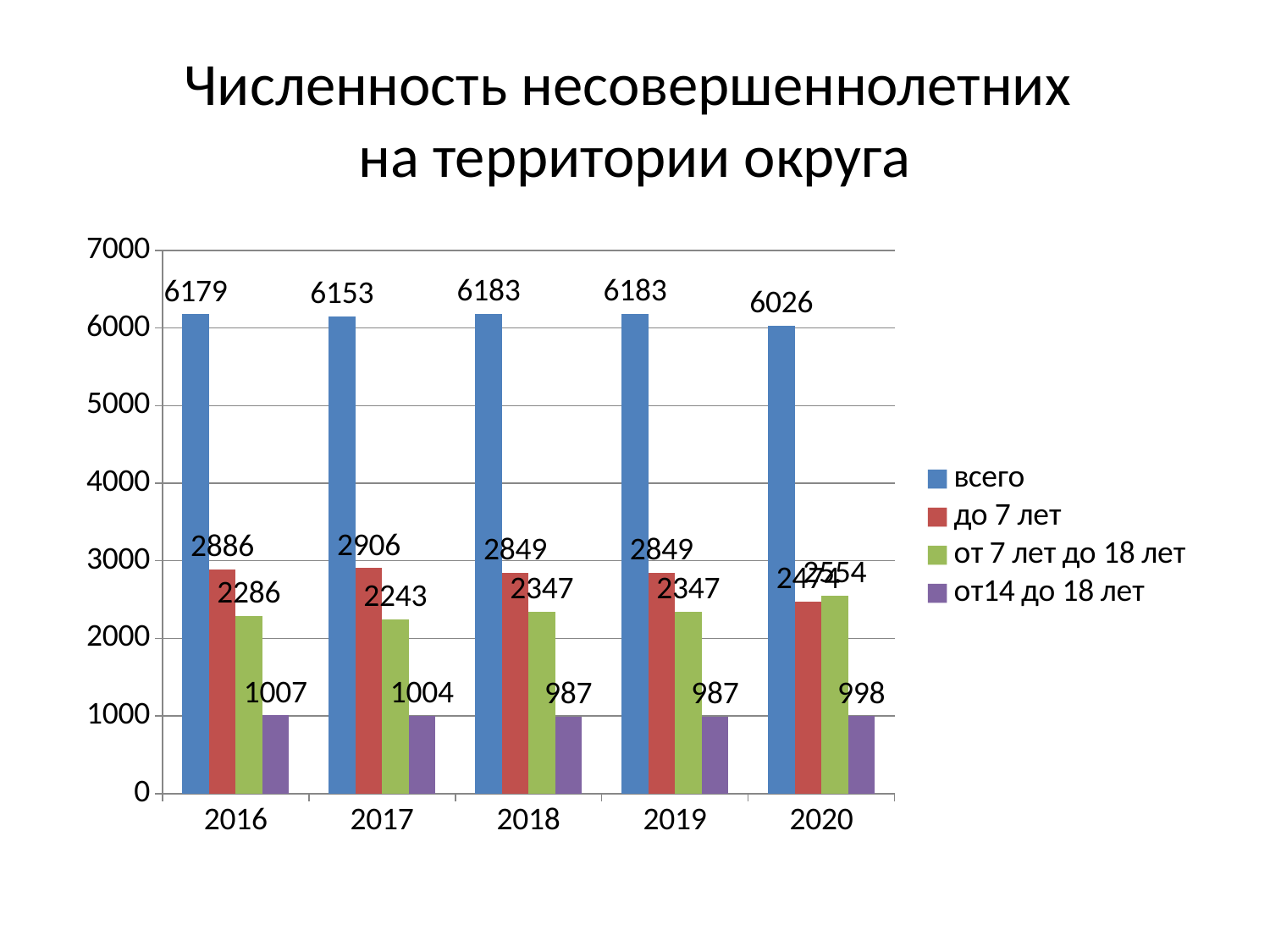
What kind of chart is shown on the slide? bar chart In which year is the "от14 до 18 лет" value highest? 2016 What is the value for "всего" in 2016? 6179 What is the value for "до 7 лет" in 2017? 2906 What is the difference between the "всего" values for 2016 and 2020? 153 How many series does the legend list? 4 Is the value for "от 7 лет до 18 лет" in 2020 greater or less than 2000? greater What is the value for "от 7 лет до 18 лет" in 2019? 2347 What is the value for "от14 до 18 лет" in 2018? 987 How many years are shown on the x axis? 5 Which is larger: "до 7 лет" in 2016 or "до 7 лет" in 2017? 2017 In which year is the "всего" value lowest? 2020